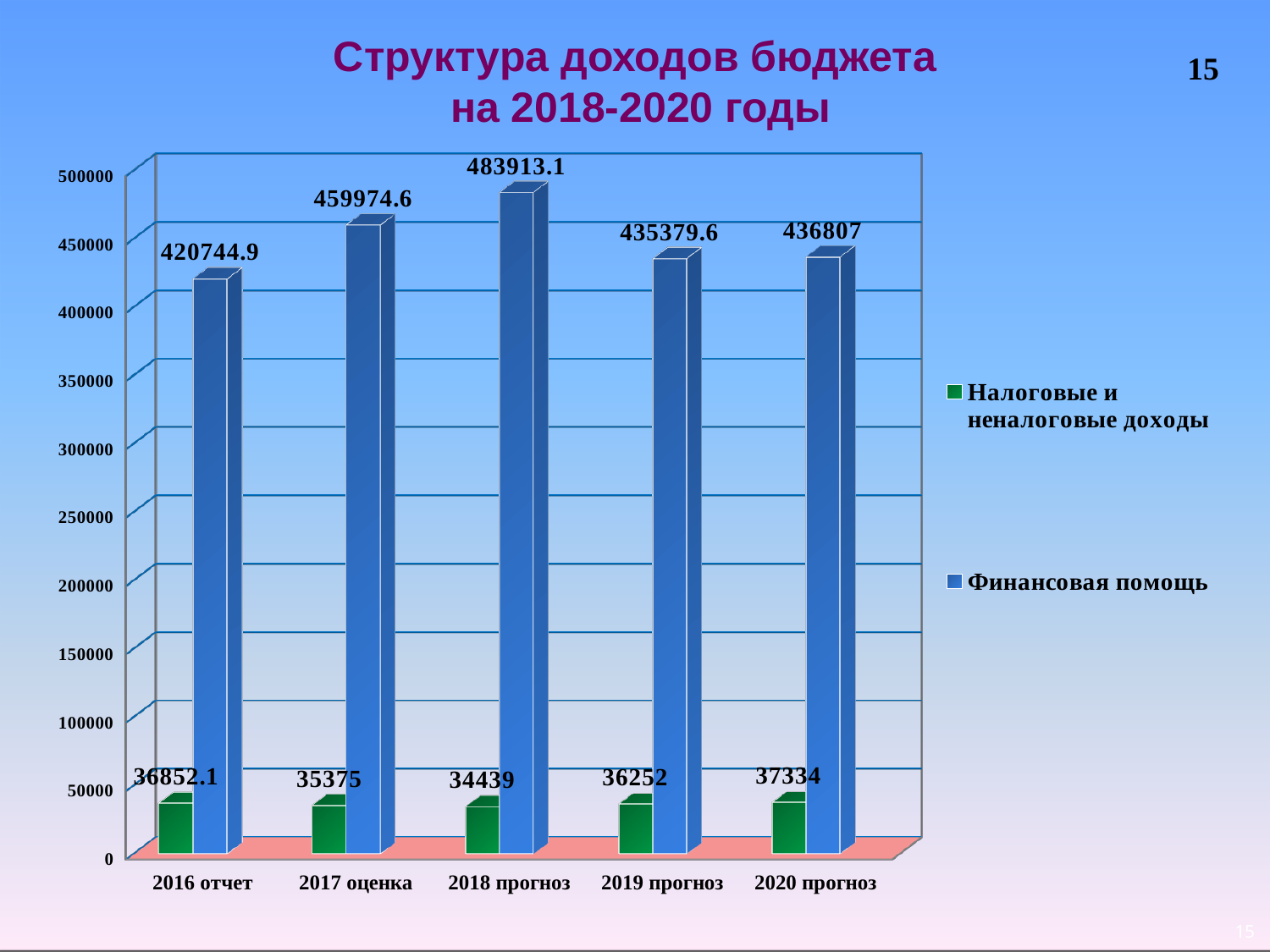
Is the value of Финансовая помощь for 2016 отчет greater or less than 400000? greater What is the value of Налоговые и неналоговые доходы for 2016 отчет? 36852.1 In which category is Налоговые и неналоговые доходы the lowest? 2018 прогноз What is the difference between Налоговые и неналоговые доходы for 2020 прогноз and 2018 прогноз? 2895 How many categories are shown on the x axis? 5 What is the difference between Финансовая помощь for 2018 прогноз and 2017 оценка? 23938.5 How many series does the legend list? 2 What is the value of Финансовая помощь for 2020 прогноз? 436807 What is the value of Финансовая помощь for 2018 прогноз? 483913.1 Which is larger: Финансовая помощь for 2017 оценка or for 2019 прогноз? 2017 оценка In which category is Финансовая помощь the highest? 2018 прогноз What type of chart is shown on the slide? bar chart